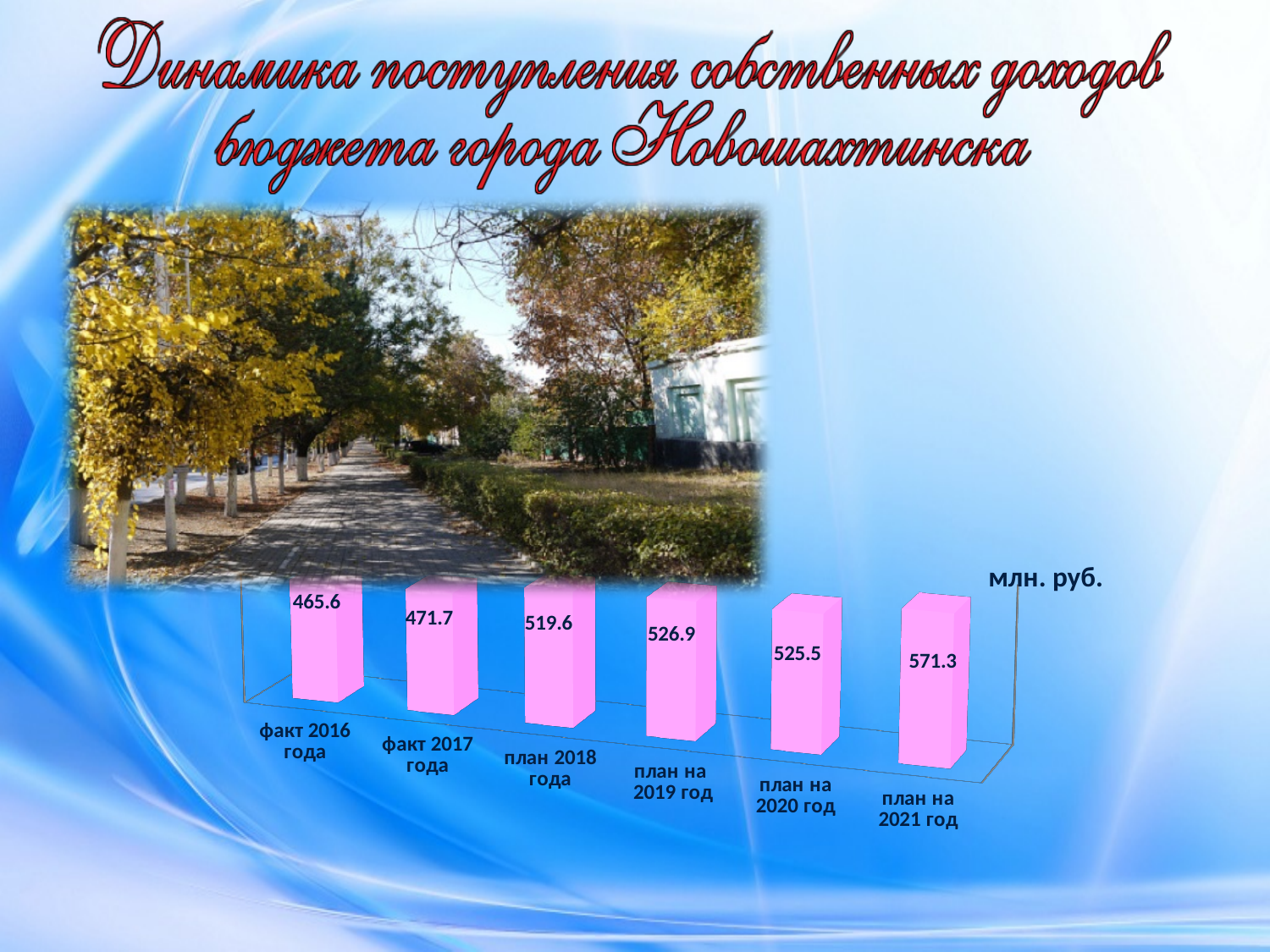
How many categories are shown in the chart? 6 Which is larger, the value for план на 2019 год or план на 2020 год? план на 2019 год What is the value for план на 2021 год? 571.3 What is the value for факт 2016 года? 465.6 What is the difference between the values for план на 2021 год and факт 2016 года? 105.7 What is the difference between the values for план 2018 года and факт 2017 года? 47.9 Do the values generally rise or fall from факт 2016 года to план на 2021 год? rise What kind of chart is shown on the slide? bar chart Which category has the highest value? план на 2021 год What unit is indicated for the values in the chart? млн. руб. Which category has the lowest value? факт 2016 года What is the value for план на 2019 год? 526.9